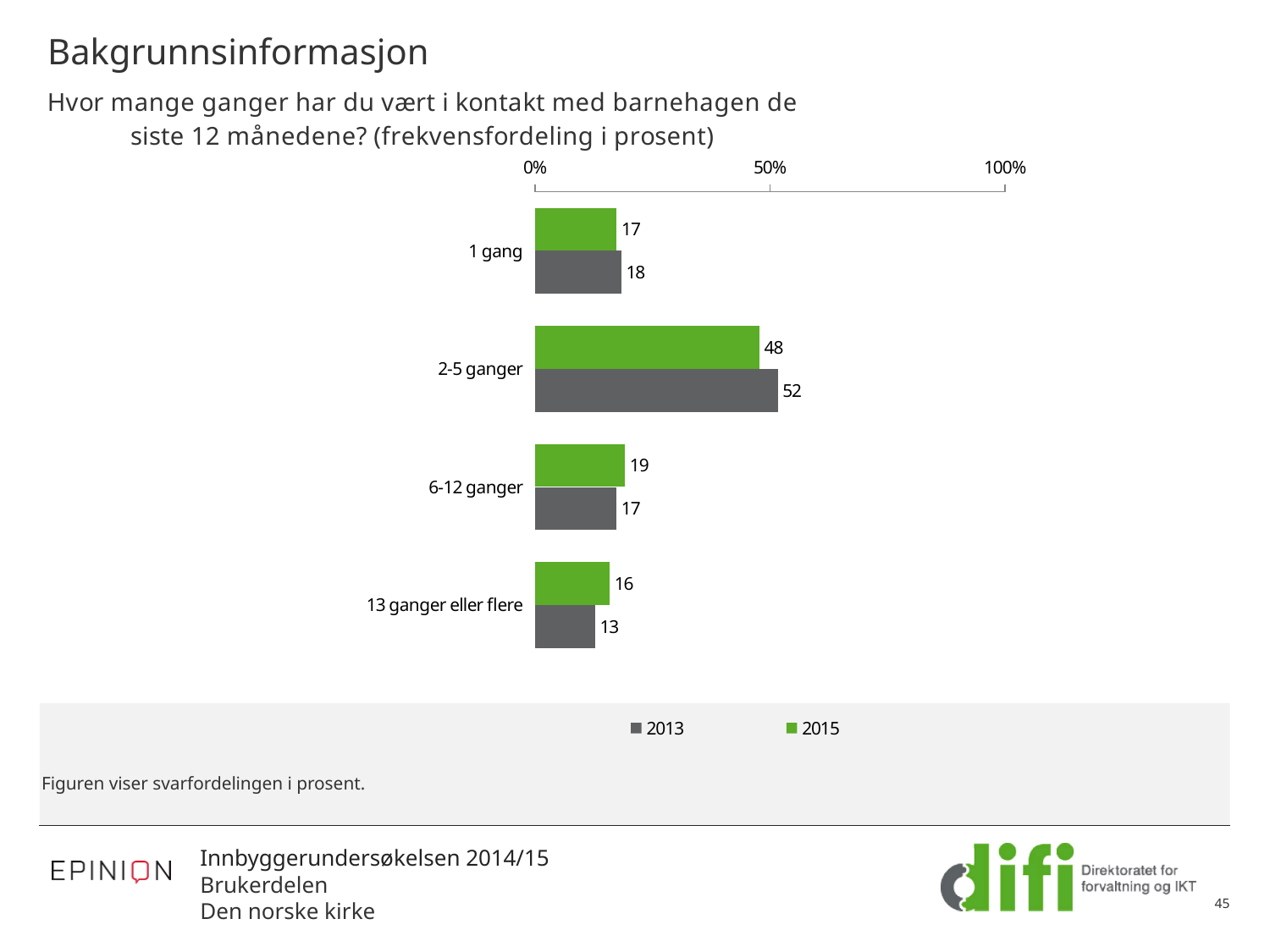
What is the 2013 value for "13 ganger eller flere"? 13 Which colour represents the 2015 series? Green Is the 2013 value for "2-5 ganger" greater or less than 50%? greater How many series does the legend list? 2 Which category has the highest 2013 value? 2-5 ganger Which is larger for "6-12 ganger": the 2013 value or the 2015 value? 2015 What is the 2013 value for "1 gang"? 18 What is the 2015 value for "2-5 ganger"? 48 How many categories are shown on the chart? 4 What is the difference between the 2013 and 2015 values for "2-5 ganger"? 4 Which category has the lowest 2015 value? 13 ganger eller flere What kind of chart is shown on the slide? Bar chart